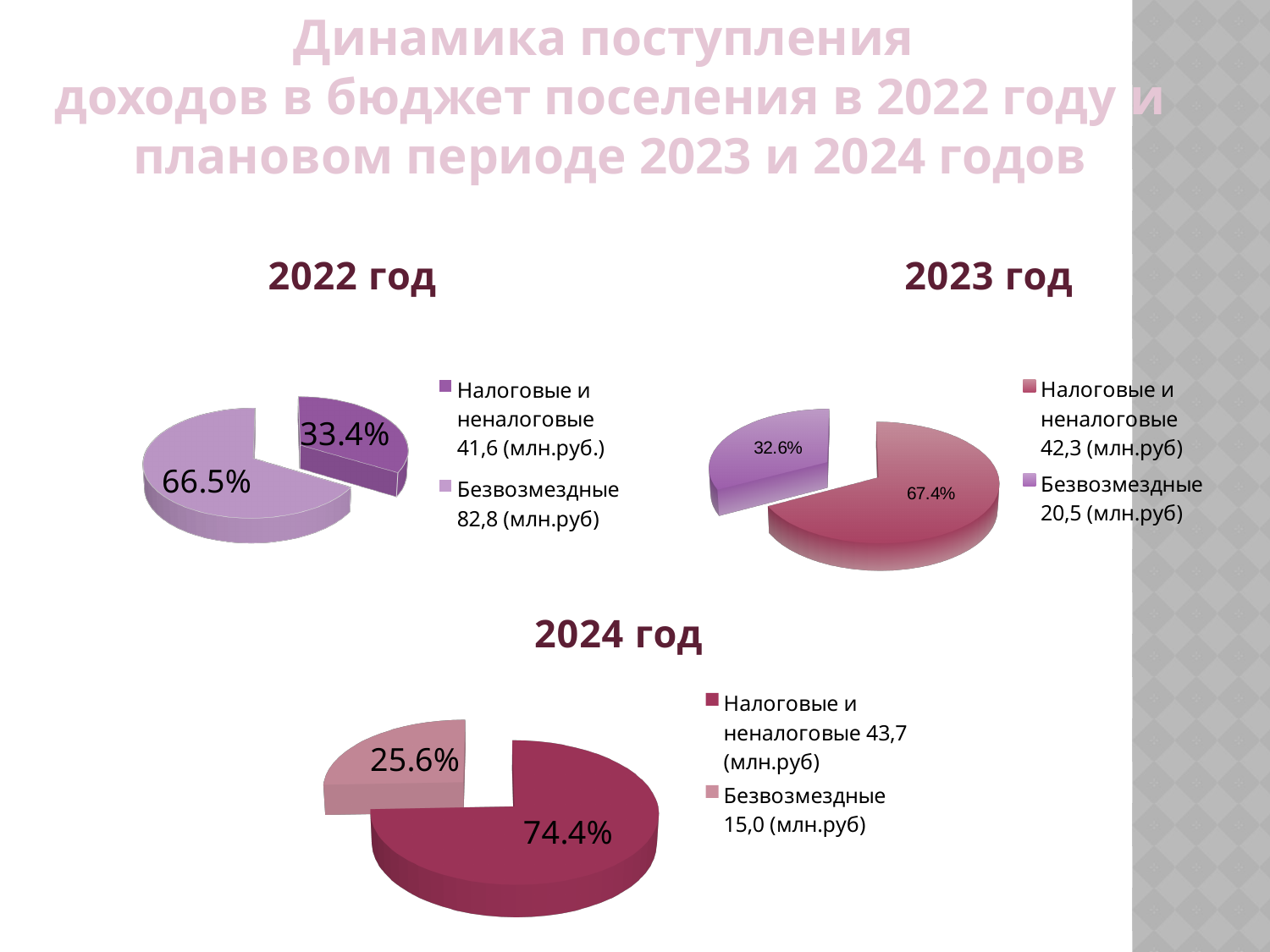
In the 2022 год chart, what percentage is shown for Налоговые и неналоговые? 33.4% How many slices does the 2024 год pie chart have? 2 In the 2024 год chart, what share of the pie is labelled for Безвозмездные? 25.6% In the 2023 год chart, what is the difference in percentage points between the two slices? 34.8 In the 2023 год chart legend, what amount in млн.руб is given for Безвозмездные? 20,5 (млн.руб) In the 2022 год chart, which category has the larger slice? Безвозмездные In the 2024 год chart, what percentage is shown for Налоговые и неналоговые? 74.4% In the 2022 год chart, what share of the pie is labelled for Безвозмездные? 66.5% In the 2024 год chart, which category has the smaller slice? Безвозмездные What kind of chart is used for the 2022 год data? Pie chart In the 2023 год chart, what share of the pie is labelled for Безвозмездные? 32.6% In the 2023 год chart, what percentage is shown for Налоговые и неналоговые? 67.4%